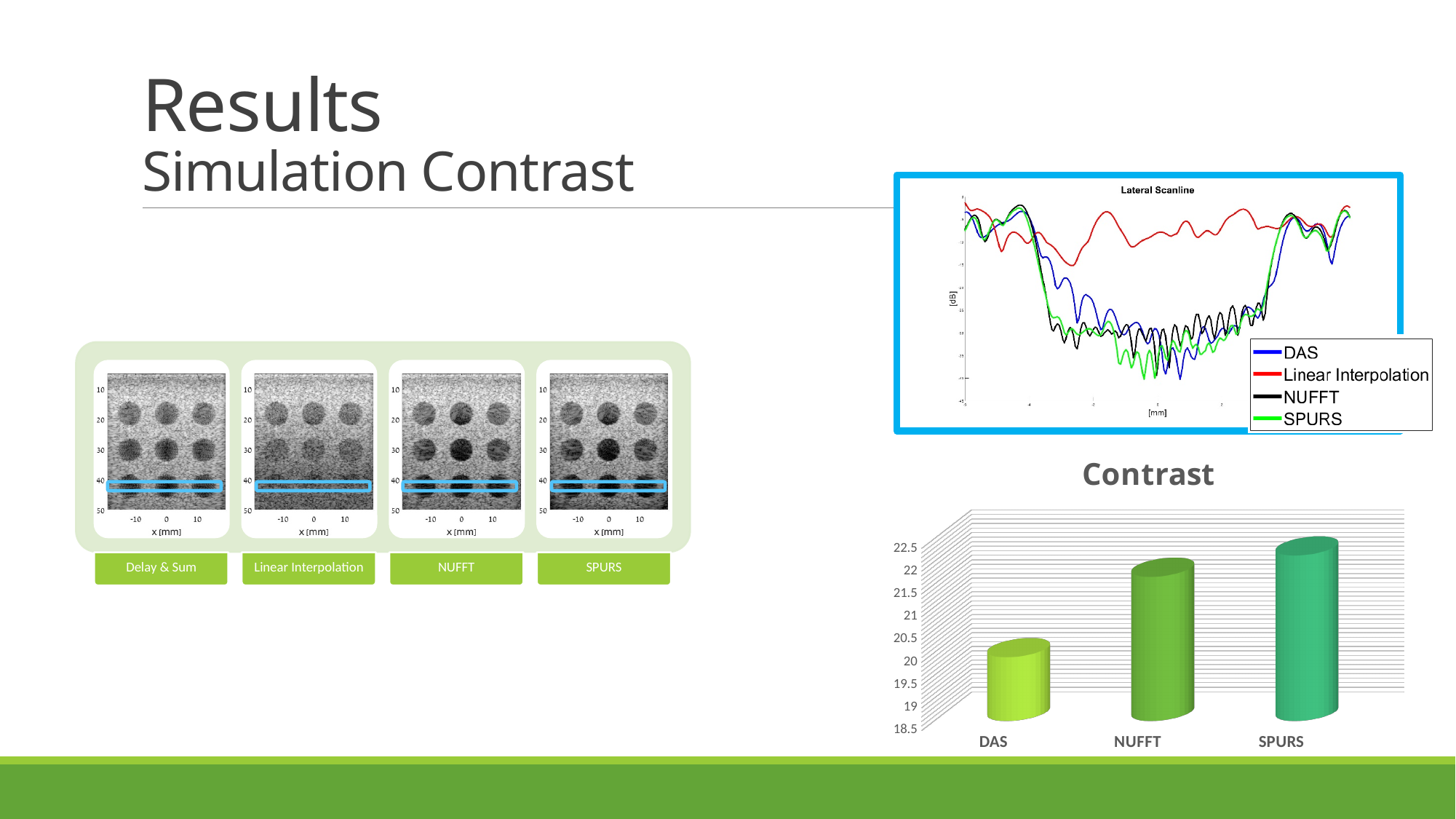
What kind of chart is the Lateral Scanline chart? line chart In the Contrast chart, do the values rise or fall from DAS to SPURS along the x axis? rise In the Contrast chart, which is larger, the value for NUFFT or the value for DAS? NUFFT What kind of chart is the Contrast chart? bar chart In the Contrast chart, which category has the lowest value? DAS How many categories are shown in the Contrast chart? 3 In the Contrast chart, which category has the highest value? SPURS In the Contrast chart, is the value for SPURS greater or less than 21? greater In the Contrast chart, is the value for NUFFT greater or less than 20? greater What is the y-axis label of the Lateral Scanline chart? [dB] How many series does the legend of the Lateral Scanline chart list? 4 In the Contrast chart, is the value for DAS greater or less than 21? less